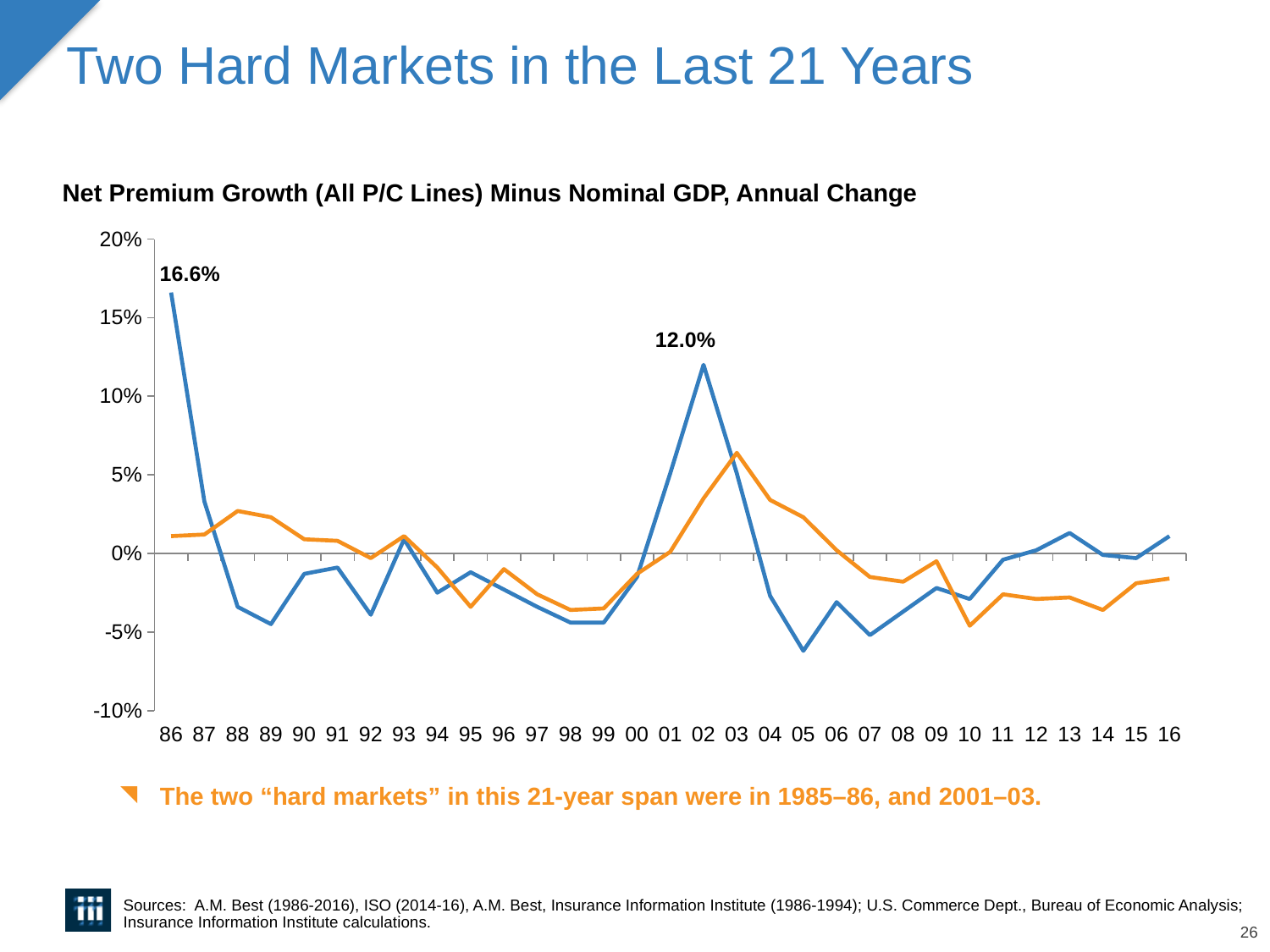
In which year does the blue line reach its highest value? 86 What is the value of the blue line in 86? 16.6% How many years are shown on the x axis? 31 In which year does the blue line reach its lowest value? 05 What kind of chart is shown on the slide? line chart Is the value of the orange line in 03 greater or less than 5%? greater What is the difference between the blue line's labeled values in 86 and 02? 4.6% What is the value of the blue line in 02? 12.0% Does the blue line rise or fall from 86 to 88? fall What is the title of the chart? Net Premium Growth (All P/C Lines) Minus Nominal GDP, Annual Change In 03, which line is higher, the blue line or the orange line? orange line Is the value of the blue line in 05 greater or less than -5%? less